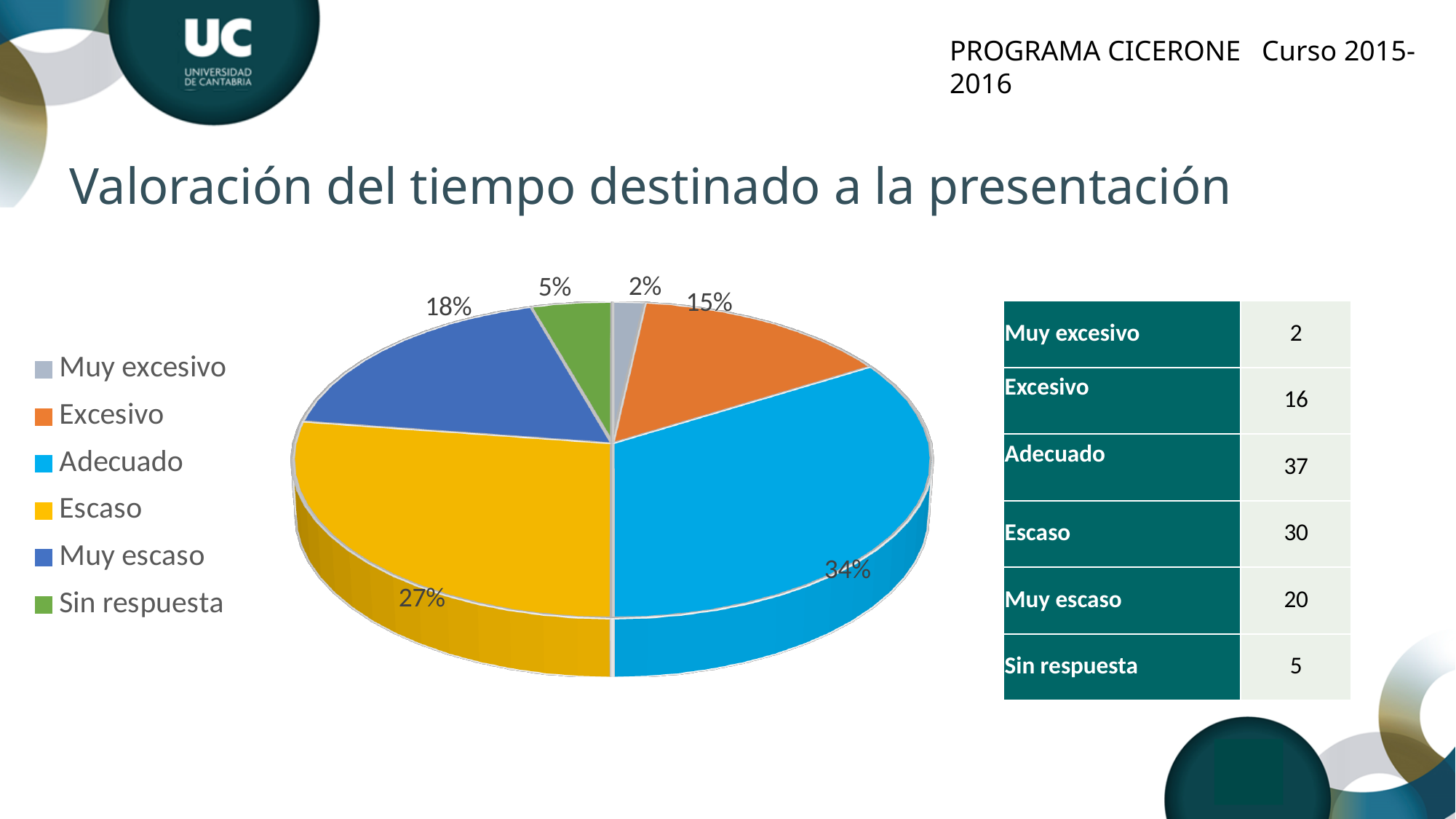
How many categories does the pie chart show? 6 What is the difference in percentage points between the Adecuado slice and the Excesivo slice? 19 What colour is the Escaso slice in the pie chart? Yellow Which category has the smallest slice of the pie? Muy excesivo What percentage of the pie does the Adecuado slice represent? 34% What percentage of the pie does the Muy escaso slice represent? 18% What percentage of the pie does the Excesivo slice represent? 15% What kind of chart is shown on the slide? Pie chart Which slice is larger, Escaso or Muy escaso? Escaso Which category has the largest slice of the pie? Adecuado